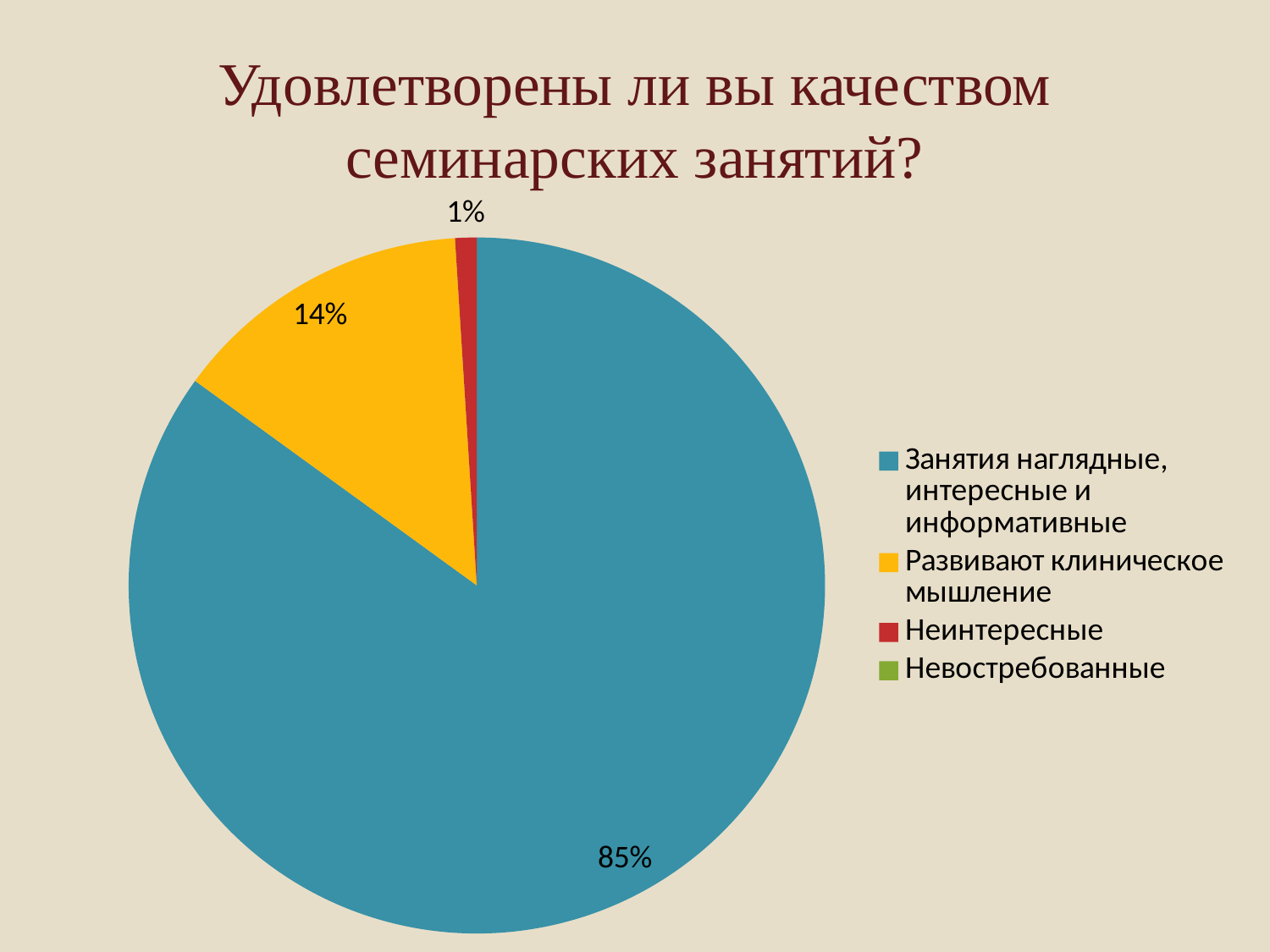
Which slice is larger: "Развивают клиническое мышление" or "Неинтересные"? Развивают клиническое мышление What kind of chart is shown on the slide? Pie chart Which category has the largest slice of the pie? Занятия наглядные, интересные и информативные How many categories does the legend list? 4 Which category is labeled with the smallest percentage shown on the pie? Неинтересные What colour is the slice for "Развивают клиническое мышление"? Yellow What is the title of the chart on the slide? Удовлетворены ли вы качеством семинарских занятий? What percentage of the pie is labeled for "Неинтересные"? 1% What percentage of the pie is labeled for "Развивают клиническое мышление"? 14% What percentage of the pie is labeled for "Занятия наглядные, интересные и информативные"? 85% By how many percentage points does the "Занятия наглядные, интересные и информативные" slice exceed the "Развивают клиническое мышление" slice? 71 percentage points How many slices of the pie have a percentage label? 3